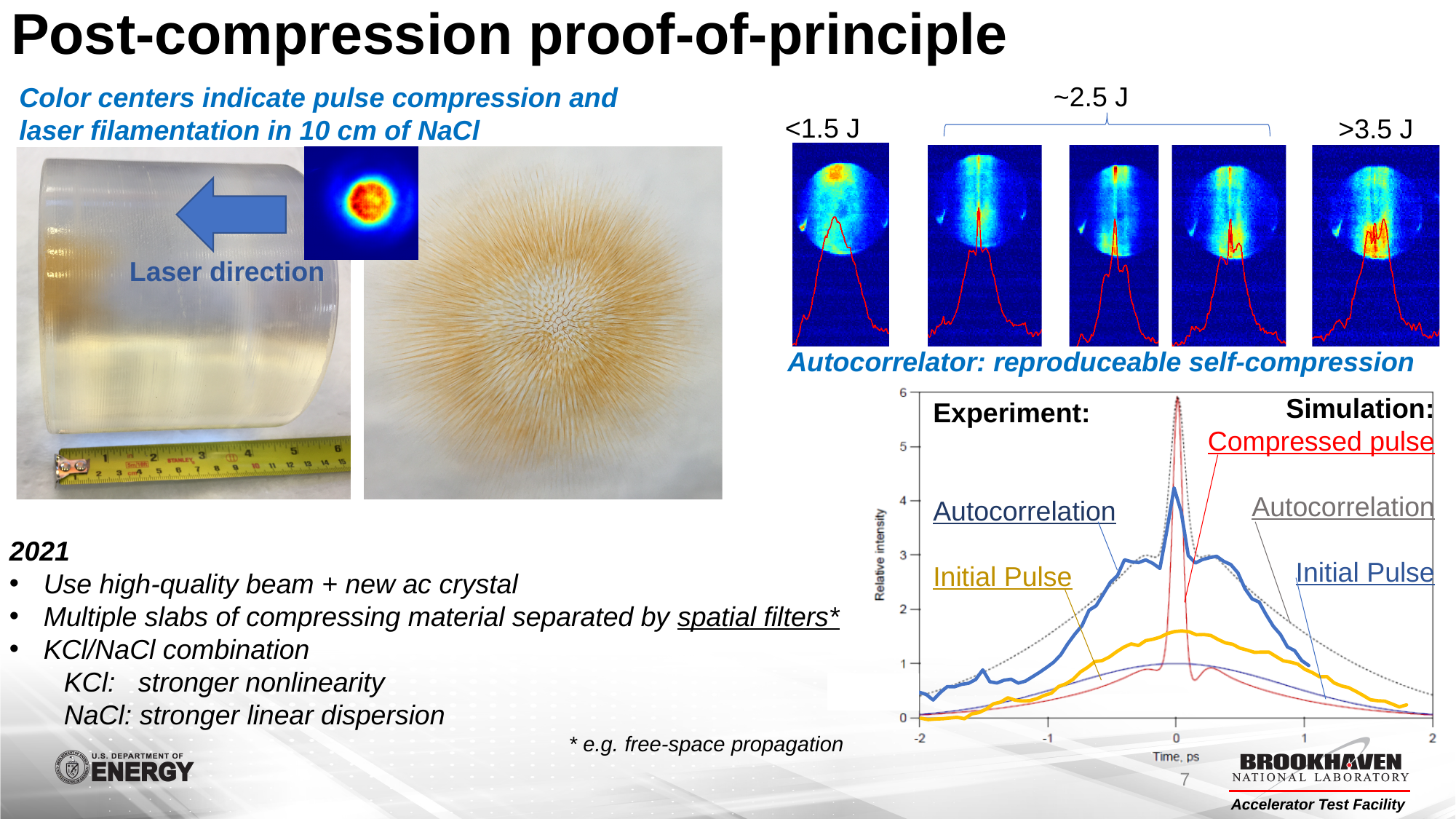
In the bottom-right chart, is the value of the simulated Initial Pulse at time 0 greater or less than 2? less In the bottom-right chart, does the experimental Autocorrelation curve rise or fall as time goes from -2 ps to 0 ps? rise In the bottom-right chart, what is the label of the y axis? Relative intensity In the bottom-right chart, is the peak value of the experimental Initial Pulse greater or less than 2? less In the bottom-right chart, what is the label of the x axis? Time, ps In the bottom-right chart, which curve reaches a higher peak at time 0: the simulated Compressed pulse or the experimental Initial Pulse? Compressed pulse In the bottom-right chart, is the peak value of the simulated Compressed pulse greater or less than 5? greater What kind of chart is shown at the bottom right of the slide? line chart In the bottom-right chart, does the experimental Initial Pulse curve rise or fall as time goes from 0 ps to 1 ps? fall How many labeled curves are shown in the bottom-right chart? 5